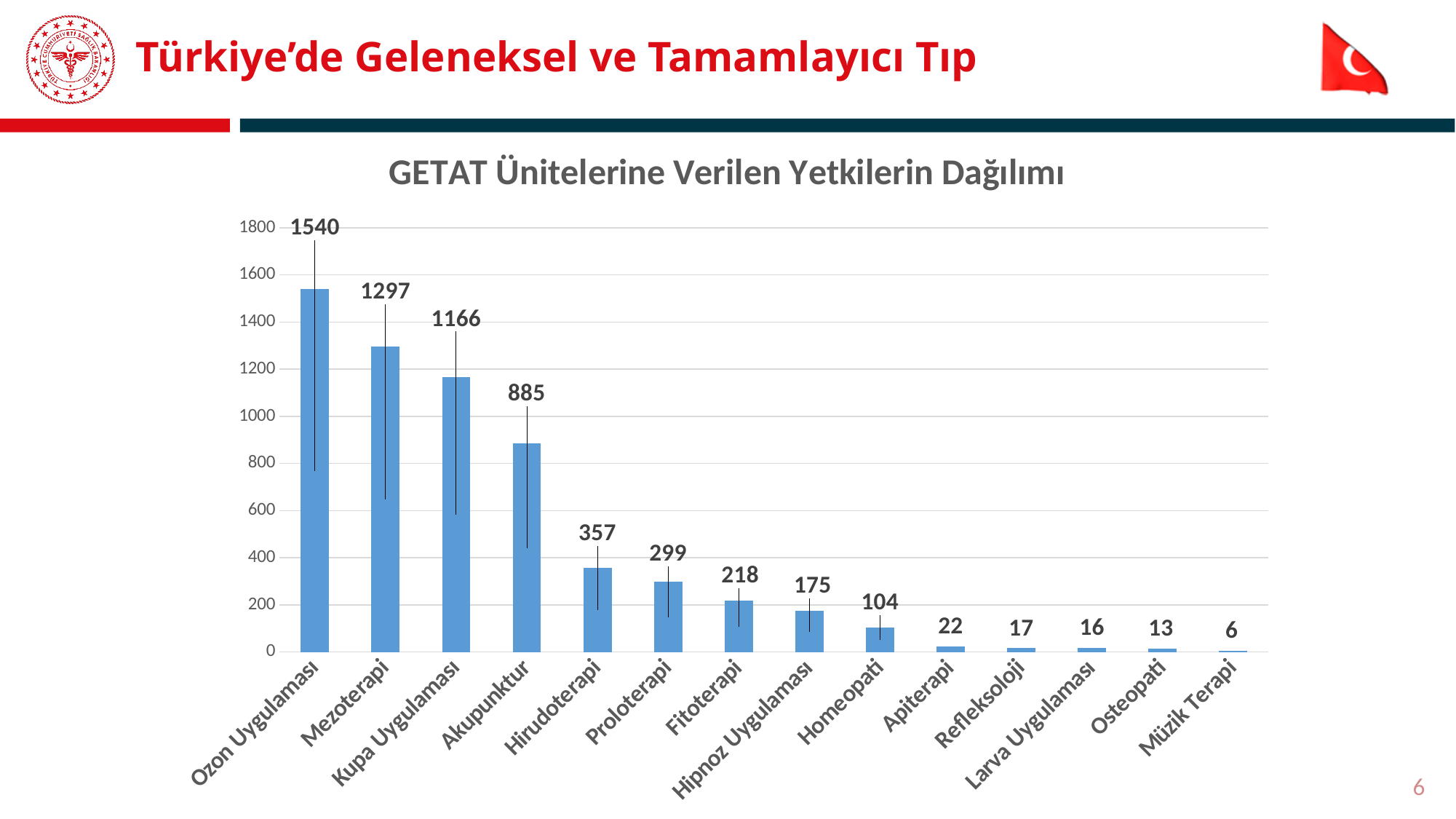
Is the value for Kupa Uygulaması greater or less than 1000? greater What is the value for Homeopati? 104 What kind of chart is shown on the slide? bar chart Which is larger, the value for Proloterapi or the value for Fitoterapi? Proloterapi What is the title of the chart? GETAT Ünitelerine Verilen Yetkilerin Dağılımı What is the value for Hirudoterapi? 357 Which category has the highest value? Ozon Uygulaması Do the values rise or fall from left to right along the x axis? fall Which category has the lowest value? Müzik Terapi What is the value for Akupunktur? 885 What is the difference between the values for Ozon Uygulaması and Mezoterapi? 243 How many categories are shown on the x axis? 14